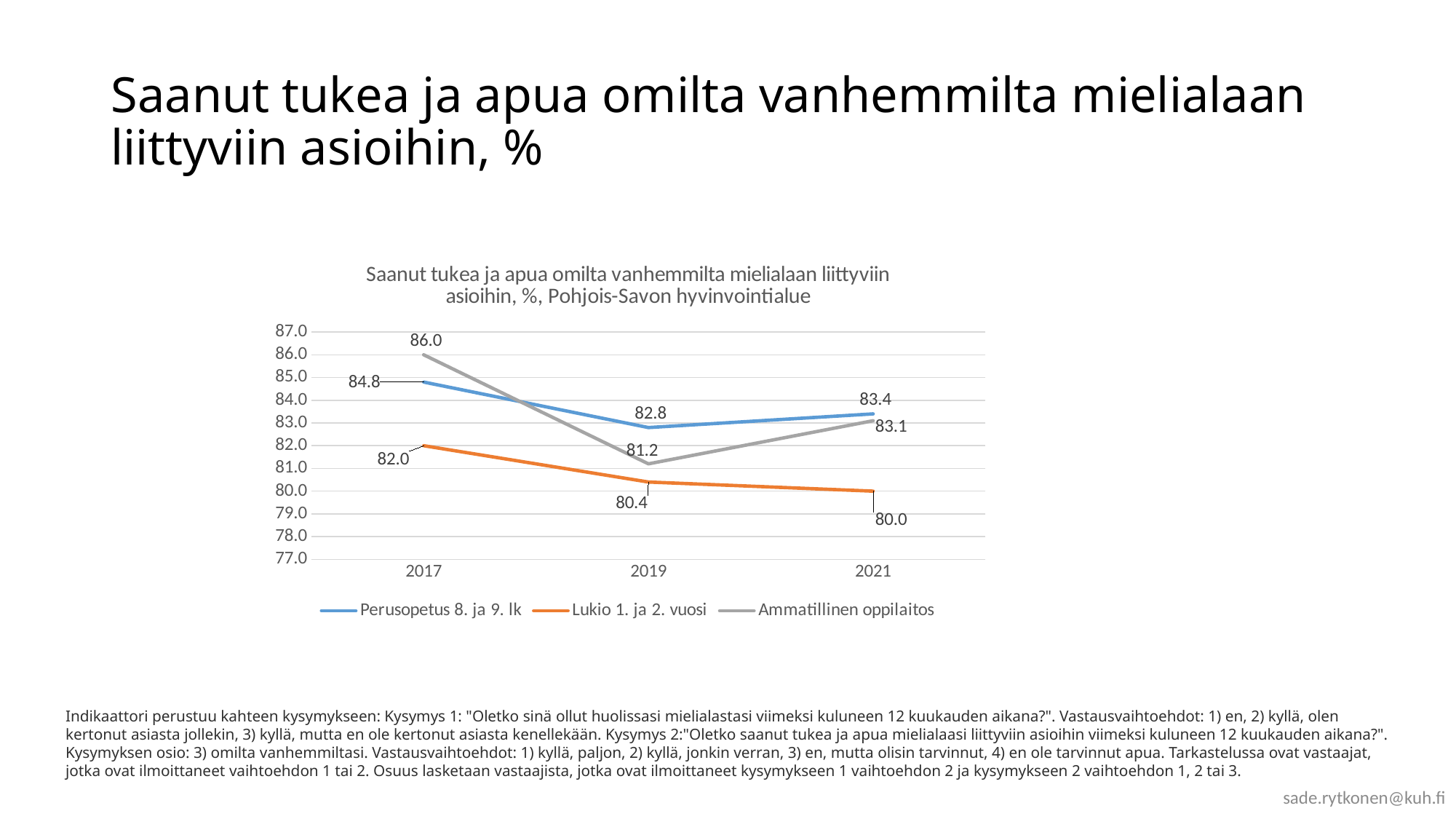
Which region is named in the chart title? Pohjois-Savon hyvinvointialue Which is larger in 2019: Perusopetus 8. ja 9. lk or Ammatillinen oppilaitos? Perusopetus 8. ja 9. lk How many years are shown on the x axis? 3 Do the values for Lukio 1. ja 2. vuosi rise or fall from 2017 to 2021? Fall What is the difference between the Ammatillinen oppilaitos values in 2017 and 2019? 4.8 What is the value for Ammatillinen oppilaitos in 2021? 83.1 How many series does the legend list? 3 Which series has the highest value in 2017? Ammatillinen oppilaitos What is the value for Perusopetus 8. ja 9. lk in 2017? 84.8 What is the value for Lukio 1. ja 2. vuosi in 2019? 80.4 Which series has the lowest value in 2021? Lukio 1. ja 2. vuosi What kind of chart is shown on the slide? Line chart